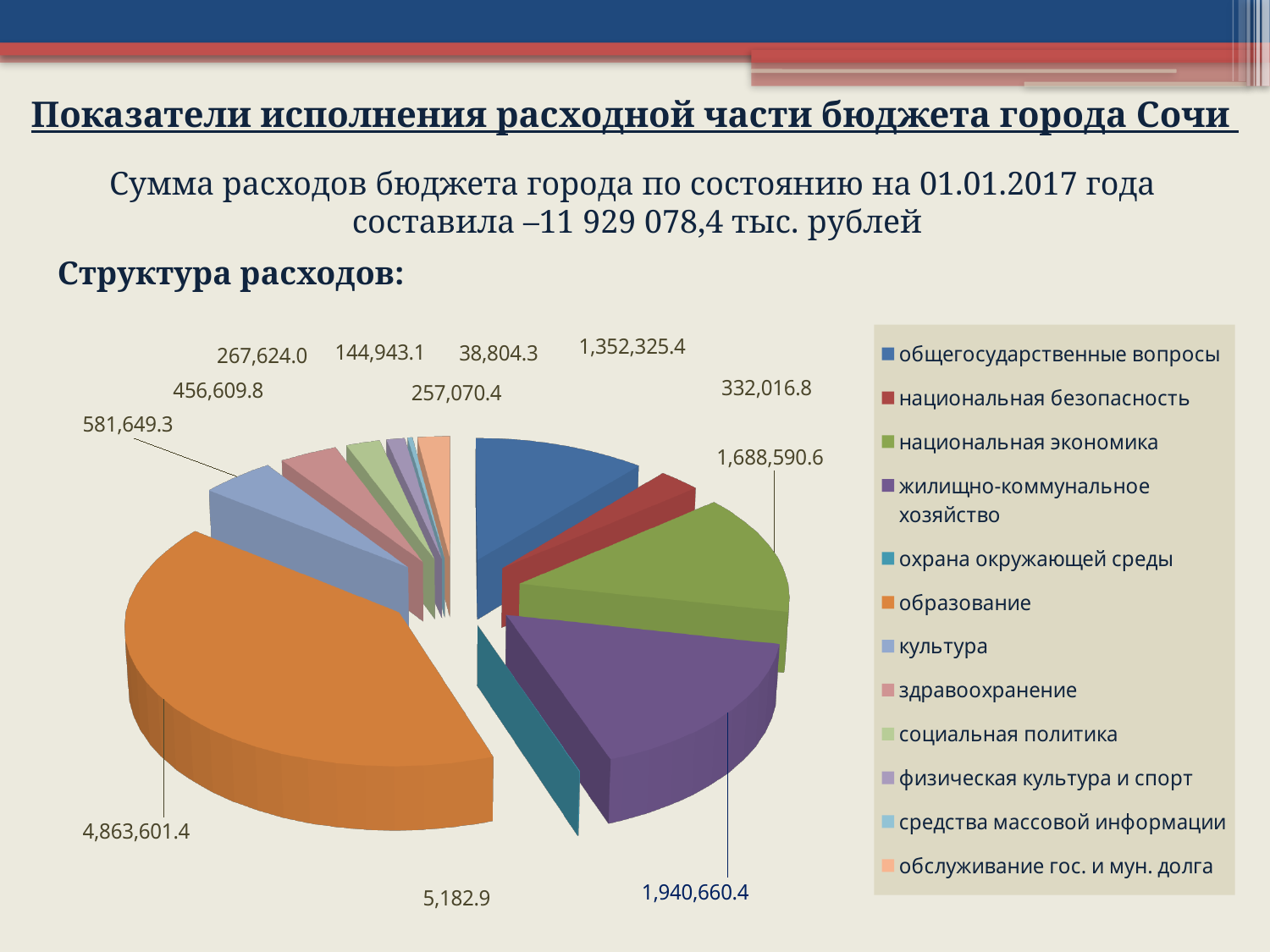
Which category has the smallest slice of the pie? охрана окружающей среды What is the value for образование in the pie chart? 4,863,601.4 What is the difference between the values for жилищно-коммунальное хозяйство and национальная экономика? 252,069.8 What kind of chart is shown on the slide? pie chart What is the value for жилищно-коммунальное хозяйство? 1,940,660.4 What is the value for охрана окружающей среды? 5,182.9 Which is larger, жилищно-коммунальное хозяйство or национальная экономика? жилищно-коммунальное хозяйство How many categories does the legend of the pie chart list? 12 What is the value for национальная экономика? 1,688,590.6 Which category has the largest slice of the pie? образование What is the total sum of expenses stated on the slide as of 01.01.2017? 11 929 078,4 тыс. рублей What is the value for общегосударственные вопросы? 1,352,325.4